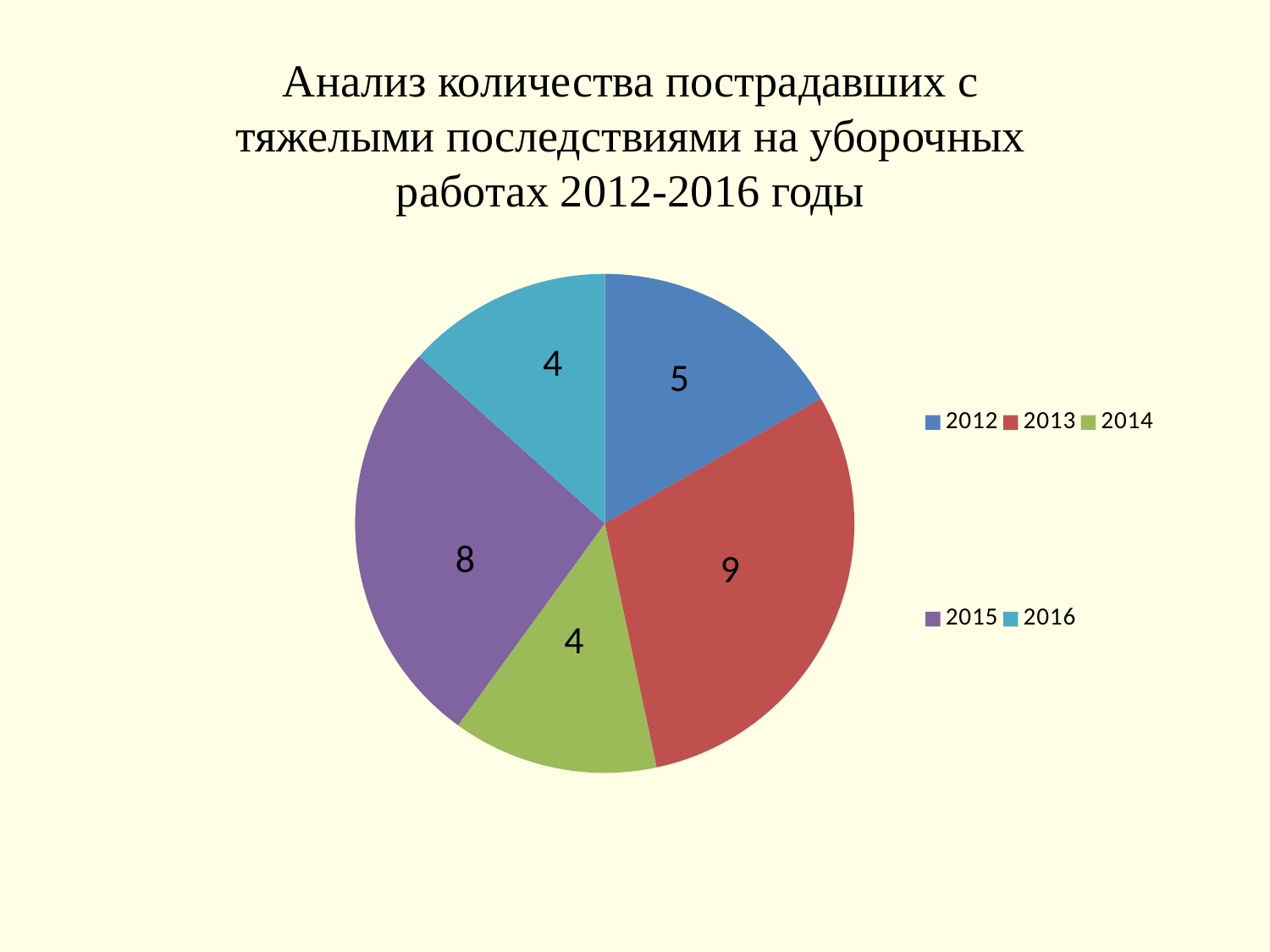
What share of the pie does the 2013 slice represent? 30% What is the total of all slices in the pie chart? 30 What is the value for 2014 in the pie chart? 4 What is the value for 2015 in the pie chart? 8 Which years share the smallest slice in the pie chart? 2014 and 2016 How many slices does the pie chart have? 5 What is the value for 2012 in the pie chart? 5 Which year has the largest slice in the pie chart? 2013 What is the value for 2013 in the pie chart? 9 What is the difference between the values for 2013 and 2012? 4 Which is larger, the value for 2015 or the value for 2012? 2015 What type of chart is shown on the slide? pie chart